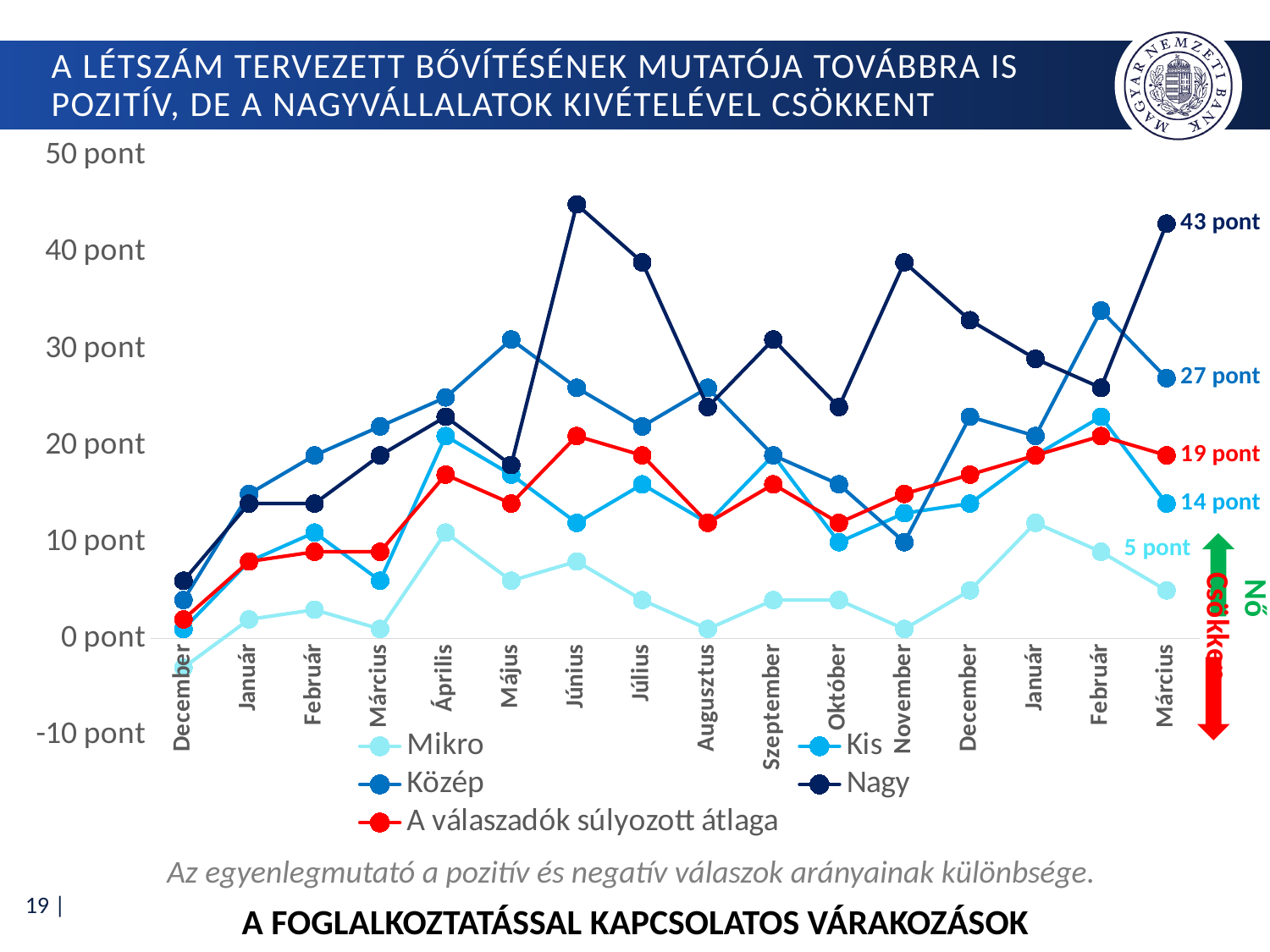
What is the value for the Kis series at the final Március point? 14 pont What kind of chart is shown on the slide? line chart What is the difference between the Nagy and Közép values at the final Március point? 16 pont What is the value for the Mikro series at the final Március point? 5 pont What is the value for the Nagy series at the final Március point? 43 pont Is the value for the Nagy series in Június greater or less than 40 pont? greater What is the value for 'A válaszadók súlyozott átlaga' at the final Március point? 19 pont Which series has the highest value at the final Március point? Nagy How many series does the legend list? 5 What is the value for the Közép series at the final Március point? 27 pont Which series has the lowest value at the final Március point? Mikro How many months are shown on the x axis? 16